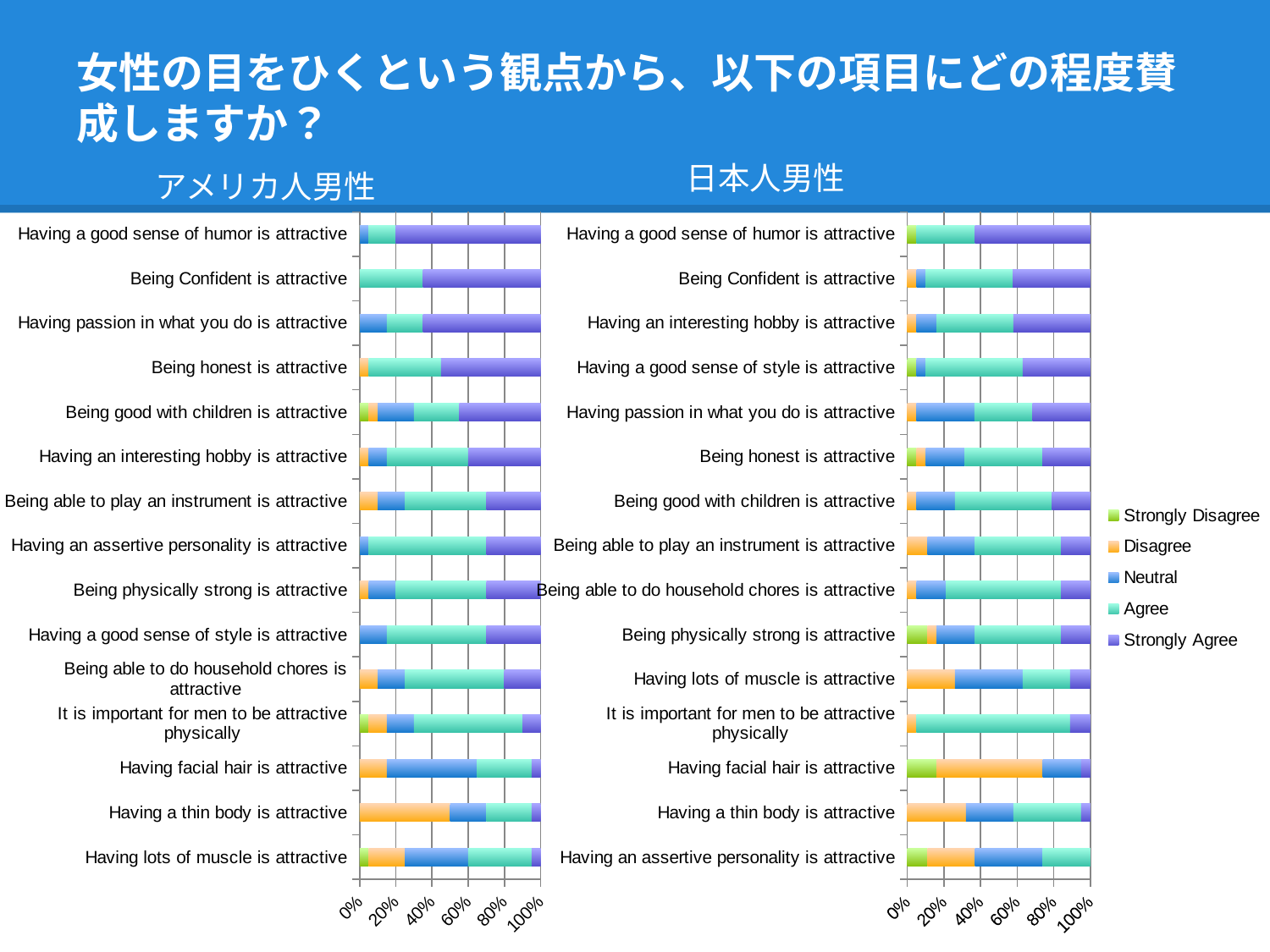
In the 日本人男性 chart, is the Strongly Agree value for 'Having a good sense of humor is attractive' greater or less than 40%? greater How many categories are shown in the 日本人男性 (Japanese men) chart? 15 In the アメリカ人男性 chart, is the Strongly Agree value for 'Having a good sense of humor is attractive' greater or less than 60%? greater How many series does the legend list? 5 In the 日本人男性 chart, is the Agree value for 'It is important for men to be attractive physically' greater or less than 60%? greater What kind of chart is used for the アメリカ人男性 (American men) data? Stacked bar chart Which category is listed last in the 日本人男性 chart? Having an assertive personality is attractive How many categories are shown in the アメリカ人男性 (American men) chart? 15 Which legend entry is shown in orange? Disagree In the アメリカ人男性 chart, which has the larger Strongly Agree share: 'Having a good sense of humor is attractive' or 'Having lots of muscle is attractive'? Having a good sense of humor is attractive